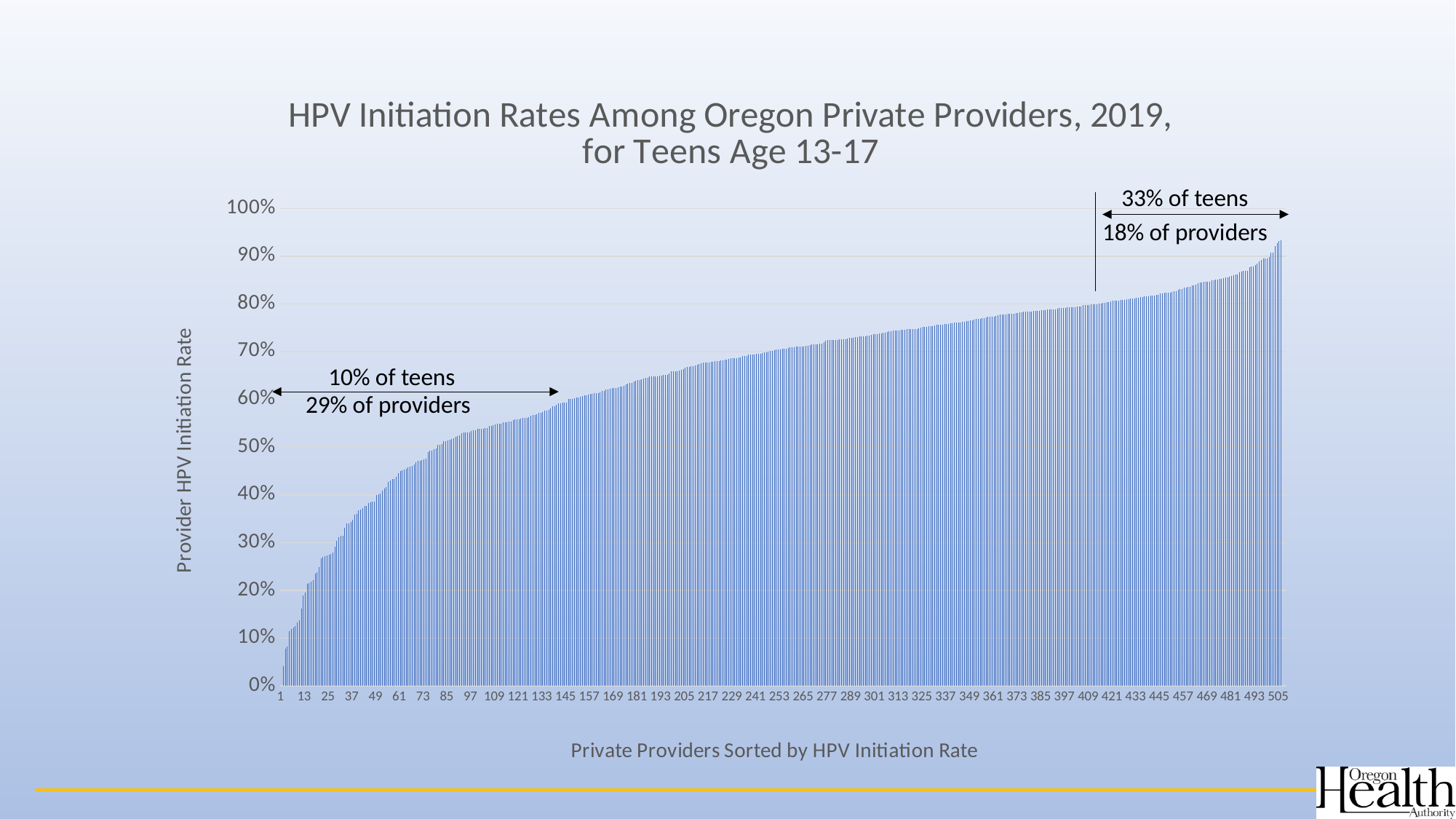
Is the HPV initiation rate for provider 361 greater or less than 70%? greater What type of chart is shown on the slide? bar chart Is the HPV initiation rate for provider 253 greater or less than 60%? greater Is the HPV initiation rate for provider 505 greater or less than 90%? greater What is the title of the chart? HPV Initiation Rates Among Oregon Private Providers, 2019, for Teens Age 13-17 According to the annotation on the left, what percentage of providers is covered by the group serving 10% of teens? 29% of providers According to the annotation on the right, what percentage of teens is covered by the top 18% of providers? 33% of teens Do the provider HPV initiation rates rise or fall from left to right along the x axis? rise What is the last provider number labelled on the x axis? 505 What is the label of the y axis? Provider HPV Initiation Rate